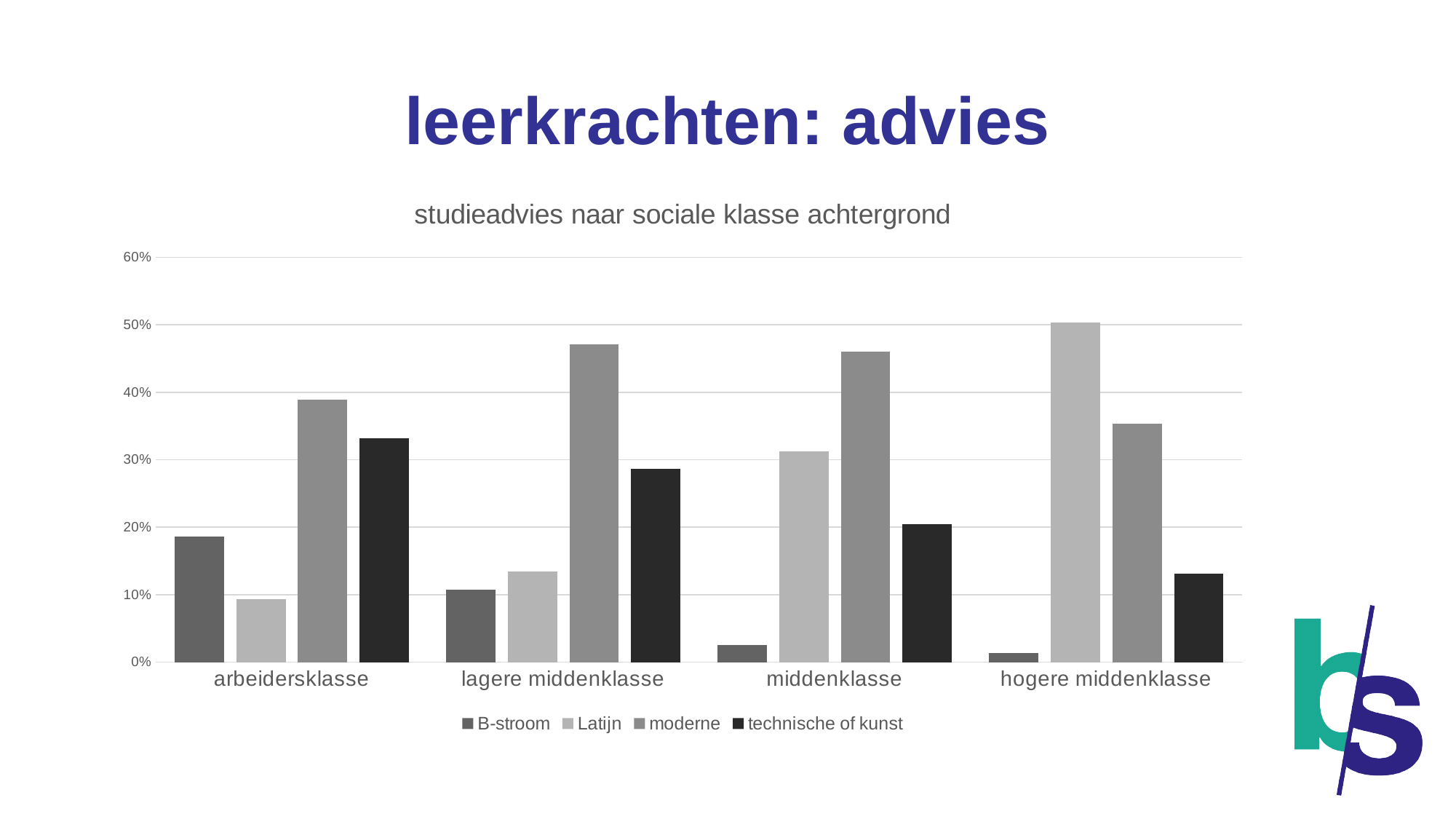
Do the B-stroom values rise or fall from arbeidersklasse to hogere middenklasse? fall How many series does the legend list? 4 How many social class categories are shown on the x axis? 4 Is the value for moderne in lagere middenklasse greater or less than 40%? greater Which series has the lowest value for middenklasse? B-stroom What kind of chart is shown on the slide? bar chart What is the title of the chart? studieadvies naar sociale klasse achtergrond Which series has the highest value for hogere middenklasse? Latijn Is the value for B-stroom in arbeidersklasse greater or less than 20%? less Which is larger for middenklasse: moderne or technische of kunst? moderne Which series has the highest value for arbeidersklasse? moderne Which series is shown in black in the legend? technische of kunst